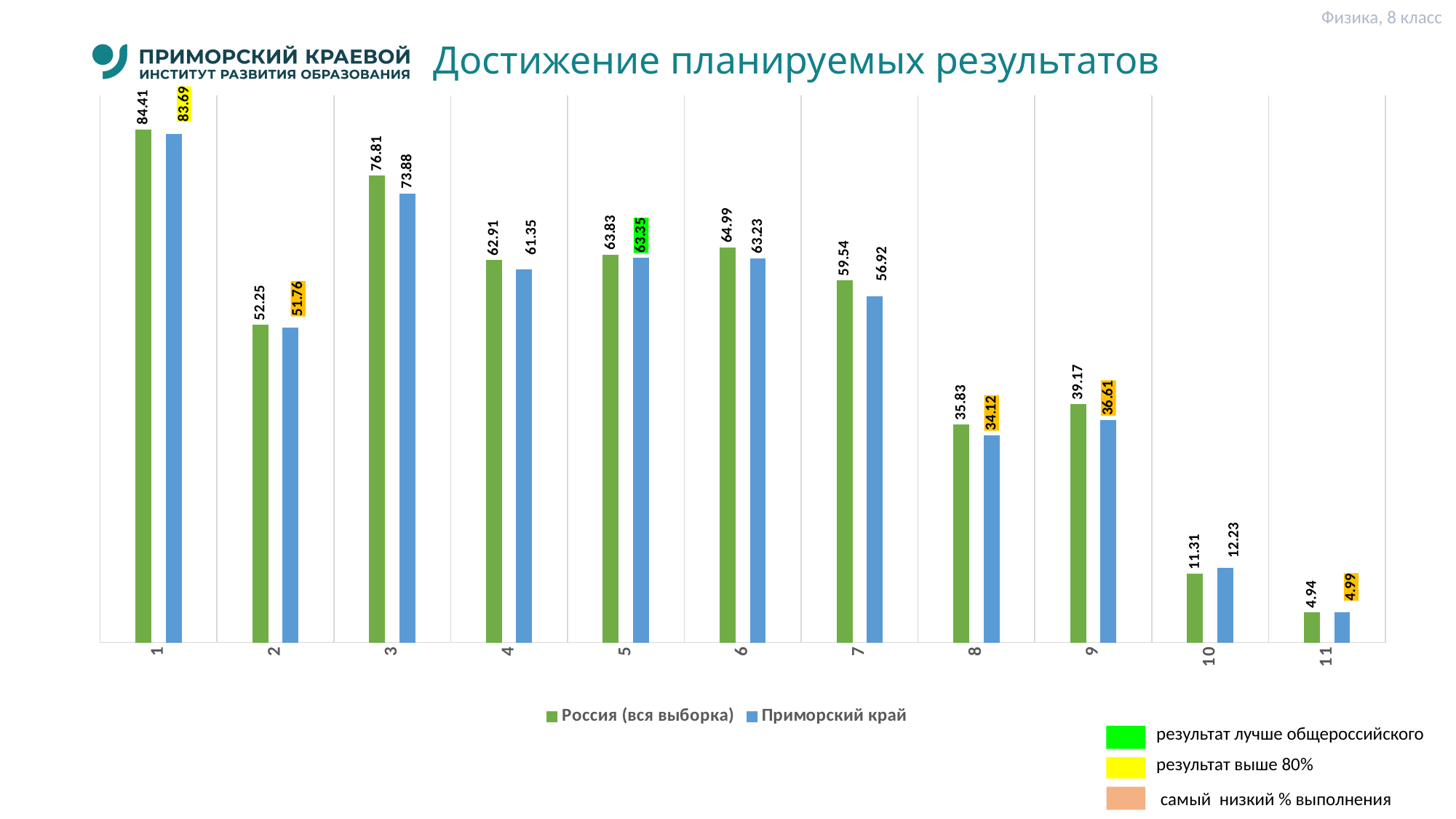
What is the difference between Россия (вся выборка) and Приморский край for category 3? 2.93 What is the value for Приморский край for category 3? 73.88 What is the difference between Россия (вся выборка) and Приморский край for category 7? 2.62 Which category has the lowest value for Россия (вся выборка)? 11 How many categories are shown on the x axis of the chart? 11 For category 9, which series has the larger value: Россия (вся выборка) or Приморский край? Россия (вся выборка) Which category has the highest value for Приморский край? 1 How many series does the chart legend list? 2 What type of chart is shown on the slide? Bar chart What is the value for Приморский край for category 10? 12.23 What is the value for Россия (вся выборка) for category 1? 84.41 For category 10, which series has the larger value: Россия (вся выборка) or Приморский край? Приморский край